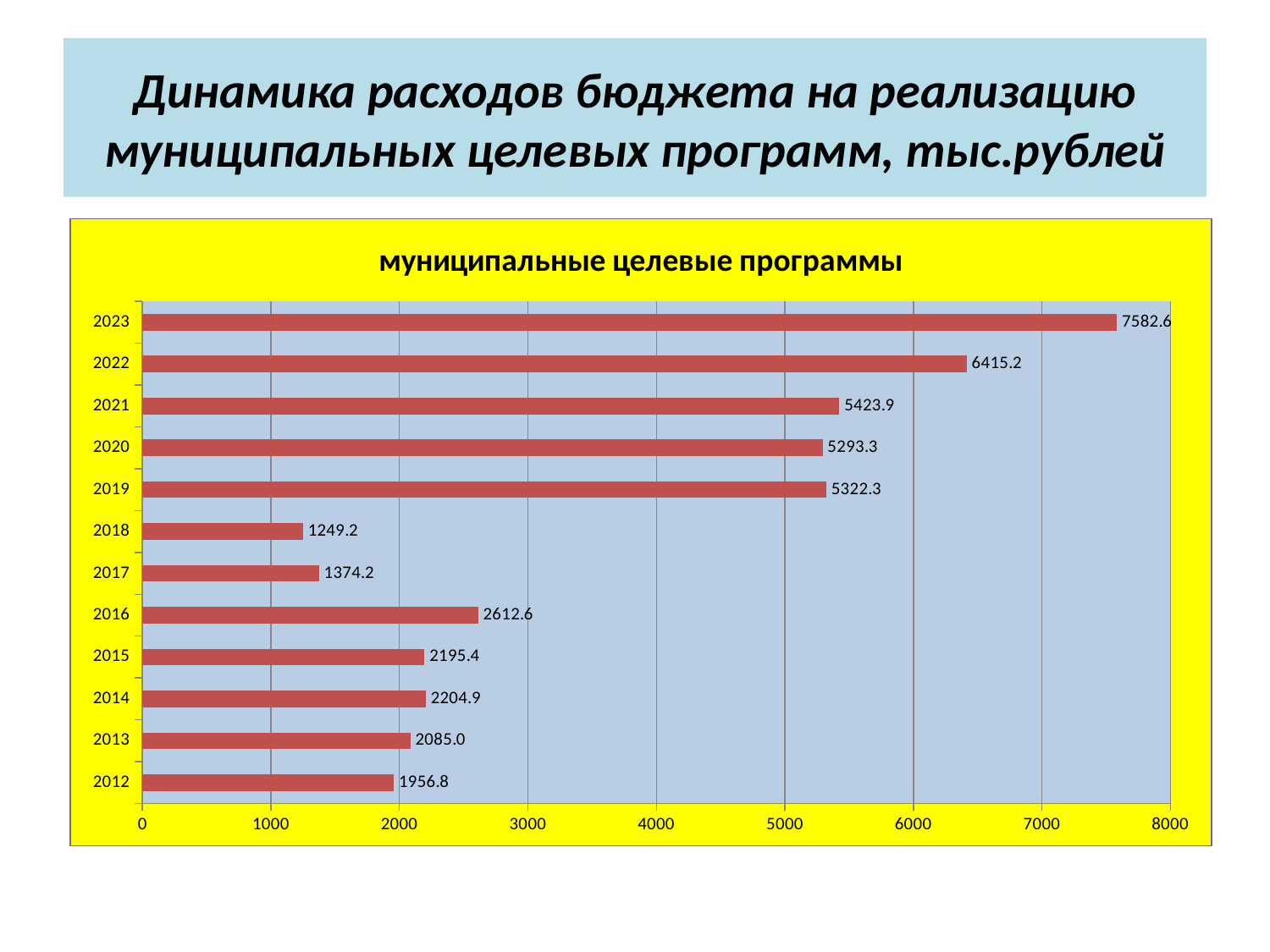
What is the difference between the values for 2019 and 2018? 4073.1 What is the value for 2012? 1956.8 What is the value for 2023? 7582.6 What is the difference between the values for 2023 and 2022? 1167.4 How many years are shown in the chart? 12 What kind of chart is shown on the slide? bar chart Which year has the highest value? 2023 What is the value for 2018? 1249.2 Which is larger, the value for 2016 or the value for 2017? 2016 What is the title of the chart? муниципальные целевые программы What is the value for 2016? 2612.6 Which year has the lowest value? 2018